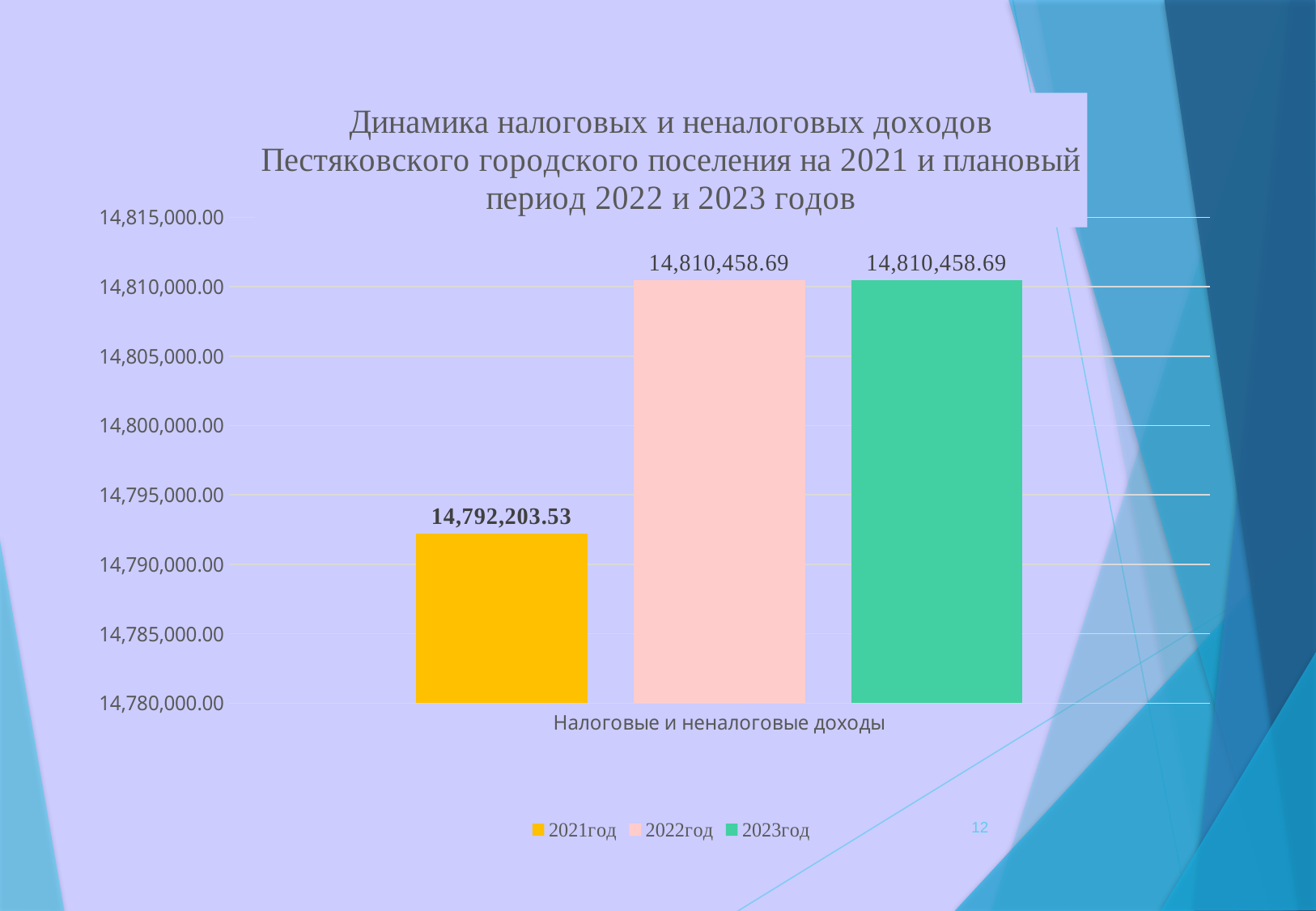
Which year has the lowest value in the chart? 2021год What is the value for 2022год in the chart? 14,810,458.69 What kind of chart is shown on the slide? bar chart What is the value for 2023год in the chart? 14,810,458.69 Is the value for 2021год greater or less than 14,795,000.00? less What is the value for 2021год in the chart? 14,792,203.53 What is the label of the category on the x axis? Налоговые и неналоговые доходы How many series does the legend list? 3 Which is larger, the value for 2021год or the value for 2022год? 2022год Is the value for 2023год greater or less than 14,805,000.00? greater What is the difference between the values for 2022год and 2021год? 18,255.16 How many categories are shown on the x axis? 1